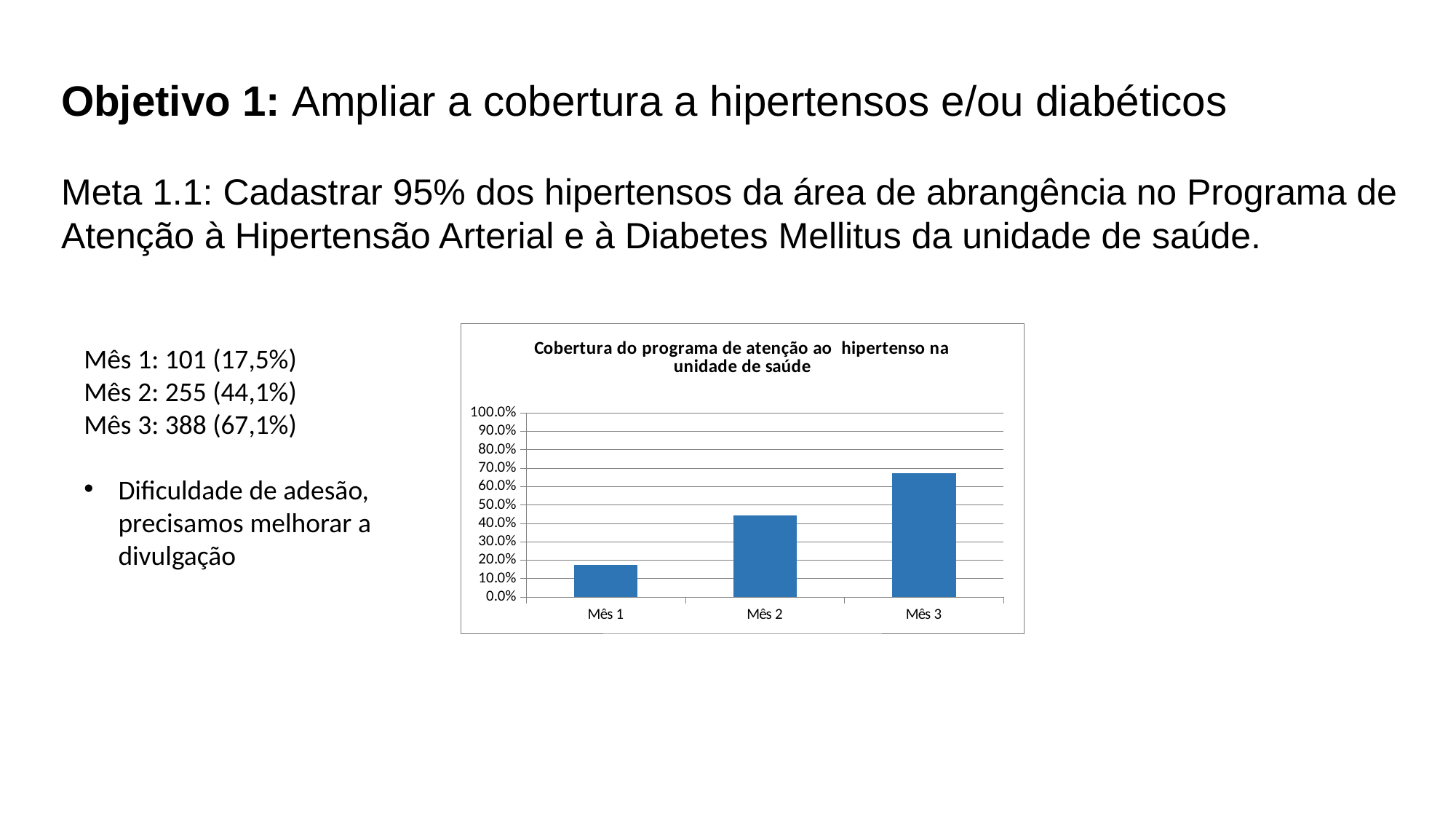
How many categories (months) are plotted in the chart? 3 Which month has the lowest coverage in the chart? Mês 1 What is the title of the chart? Cobertura do programa de atenção ao hipertenso na unidade de saúde What is the maximum value shown on the chart's vertical axis? 100.0% Is the value for Mês 3 greater or less than 70.0%? less What type of chart is shown on the slide? bar chart Which is larger, the value for Mês 2 or the value for Mês 1? Mês 2 Is the value for Mês 2 greater or less than 40.0%? greater Which month has the highest coverage in the chart? Mês 3 Do the values rise or fall from Mês 1 to Mês 3? rise Is the value for Mês 3 greater or less than 60.0%? greater